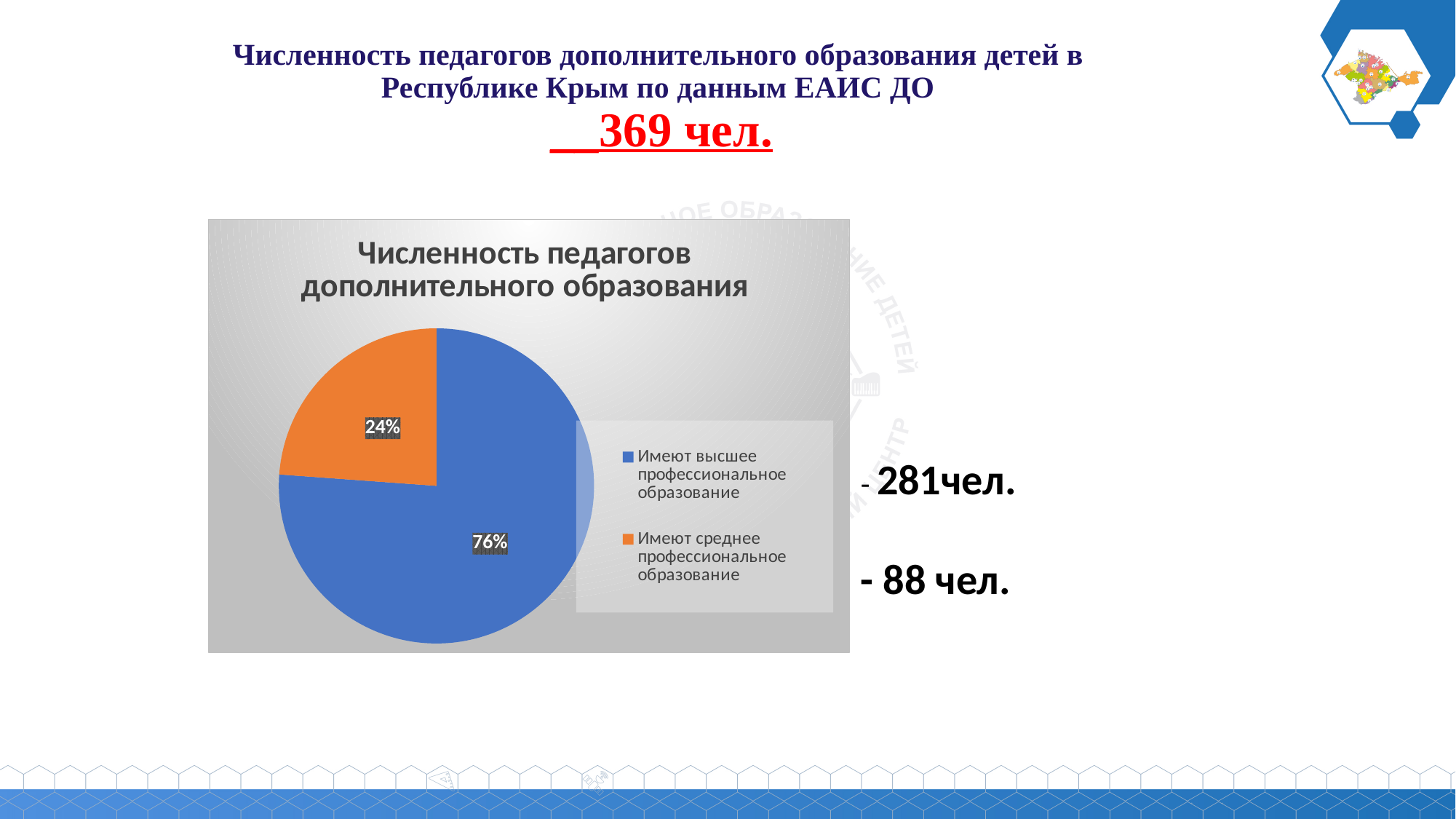
What share of the pie is labelled for "Имеют среднее профессиональное образование"? 24% What is the difference in percentage points between the two slices of the pie? 52 What kind of chart is shown on the slide? Pie chart According to the text next to the chart, how many teachers have higher professional education? 281 чел. What share of the pie is labelled for "Имеют высшее профессиональное образование"? 76% Which category has the largest slice of the pie? Имеют высшее профессиональное образование What is the title of the chart? Численность педагогов дополнительного образования Which category has the smallest slice of the pie? Имеют среднее профессиональное образование How many entries does the chart legend list? 2 What colour is the slice for "Имеют среднее профессиональное образование"? Orange How many slices does the pie chart have? 2 Which slice is larger: "Имеют высшее профессиональное образование" or "Имеют среднее профессиональное образование"? Имеют высшее профессиональное образование